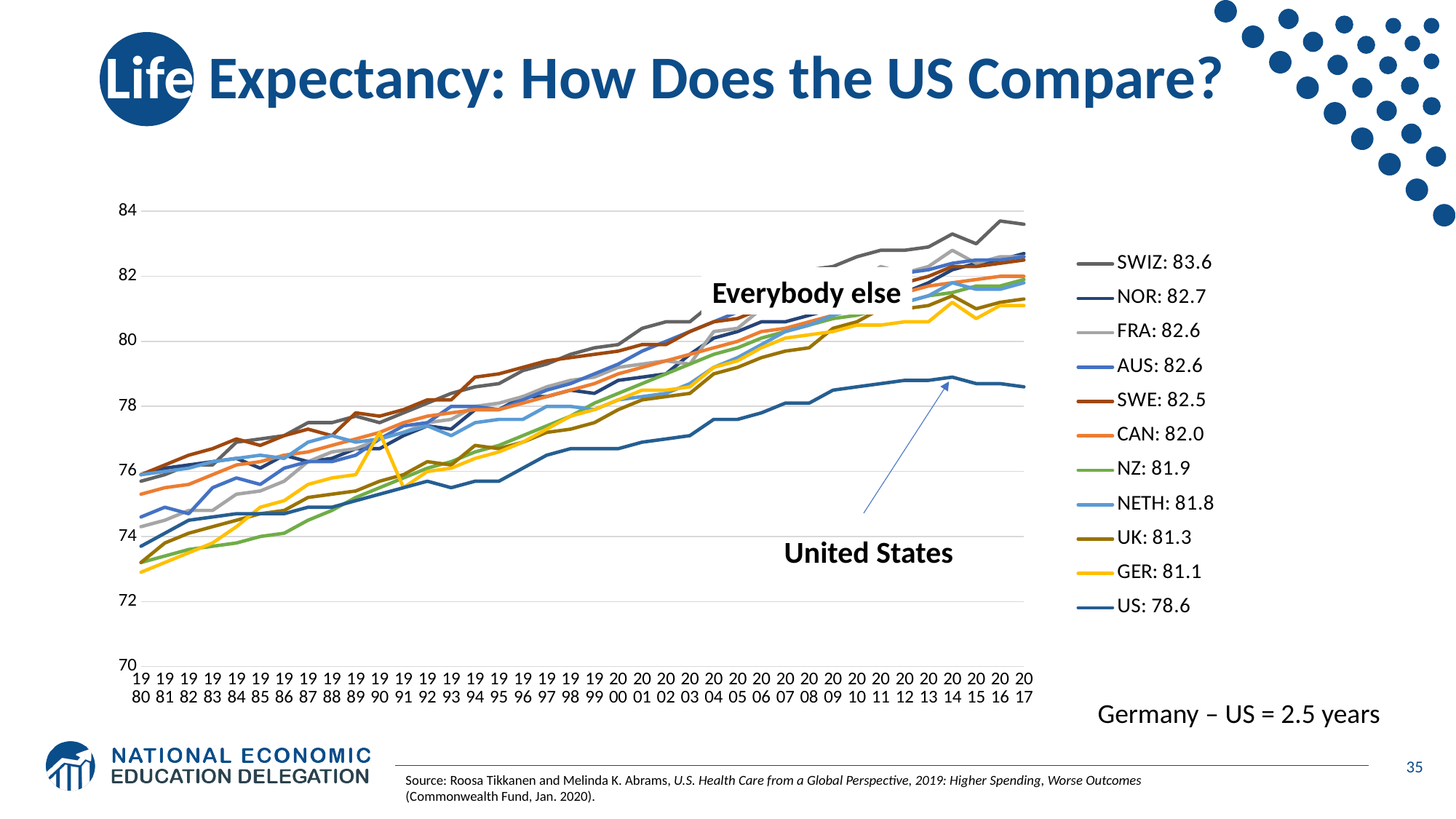
Do the life expectancy lines generally rise or fall from 1980 to 2017? Rise Is the US value in 2000 greater or less than 78? less Which country has the lowest life expectancy value in the legend? US According to the text below the legend, what is the gap between Germany and the US? 2.5 years What is the life expectancy value shown for the US in the legend? 78.6 Which has a higher legend value, NOR or CAN? NOR What type of chart is shown on the slide? Line chart What is the difference between the SWIZ value and the US value shown in the legend? 5.0 What value does the legend give for GER? 81.1 Which country has the highest life expectancy value in the legend? SWIZ What is the 2017 life expectancy value shown for SWIZ in the legend? 83.6 How many series does the legend list? 11